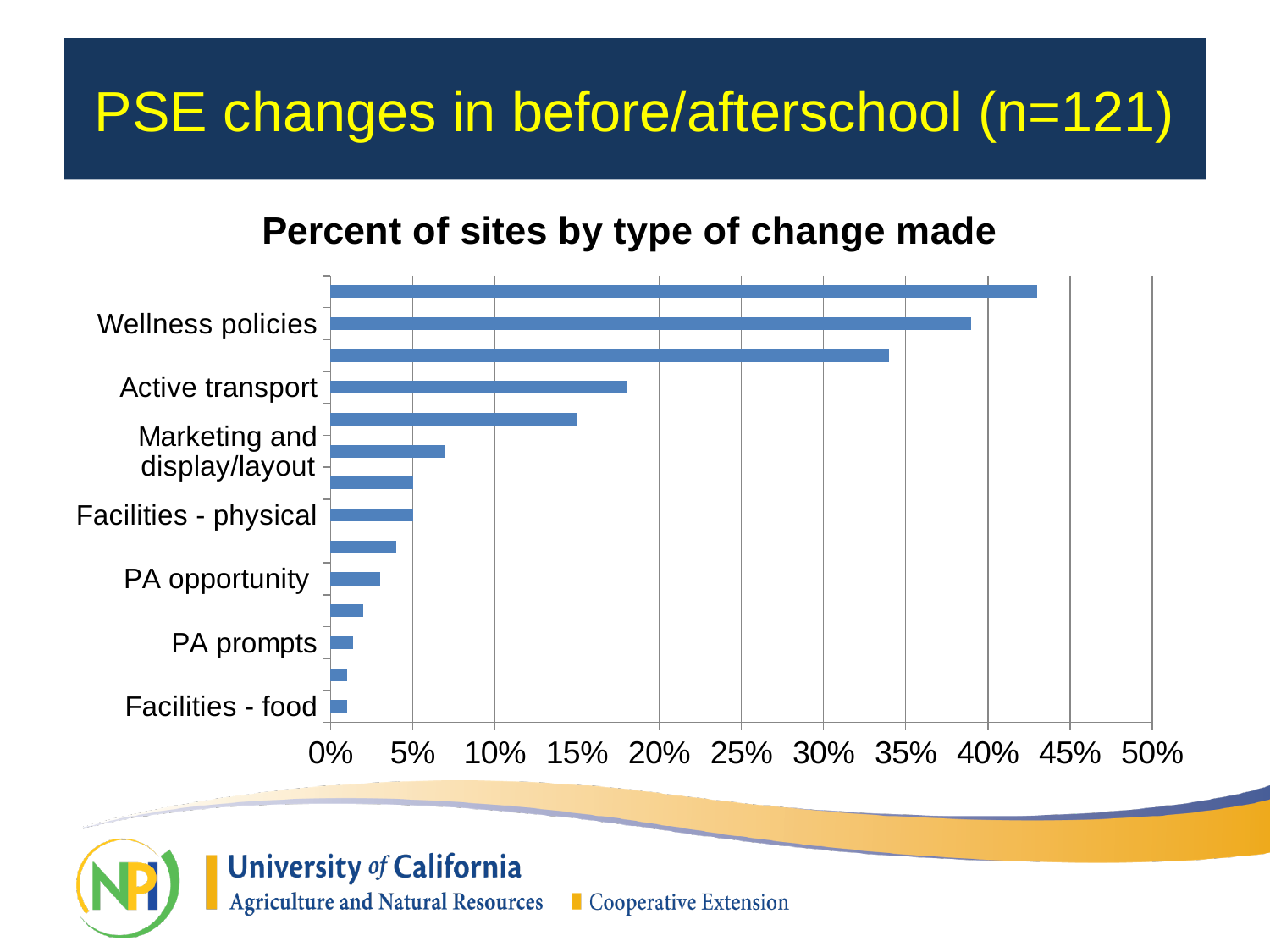
What kind of chart is shown on the slide? bar chart Is the value for PA opportunity greater or less than 5%? less Is the value for Active transport greater or less than 15%? greater What is the highest value shown on the horizontal axis? 50% Is the value for Wellness policies greater or less than 35%? greater Which has a higher value, Wellness policies or Active transport? Wellness policies What is the title of the chart? Percent of sites by type of change made Which has a higher value, Active transport or Marketing and display/layout? Active transport Of the labeled categories, which has the highest value? Wellness policies